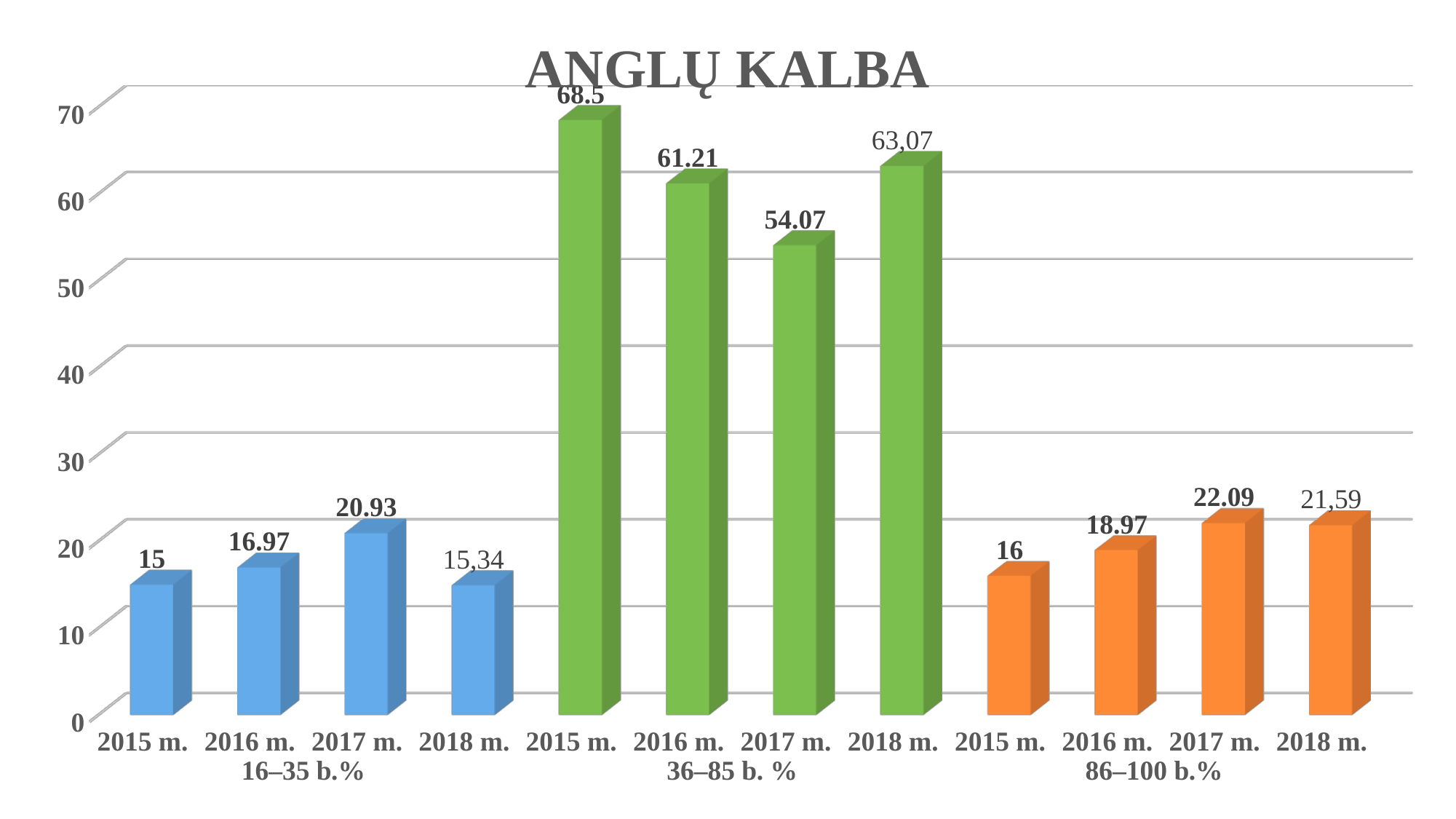
How many bars are plotted on the chart? 12 Which bar has the lowest value on the chart? 2015 m. in the 16–35 b.% group What kind of chart is shown on the slide? bar chart What is the difference between the 2015 m. and 2017 m. values in the 36–85 b. % group? 14.43 Do the values in the 86–100 b.% group rise or fall from 2015 m. to 2017 m.? rise Is the value for 2016 m. in the 36–85 b. % group greater or less than 60? greater Which bar has the highest value on the chart? 2015 m. in the 36–85 b. % group What is the title of the chart? ANGLŲ KALBA What is the value for 2018 m. in the 86–100 b.% group? 21,59 Which is larger: the 2017 m. value in the 16–35 b.% group or the 2017 m. value in the 86–100 b.% group? 2017 m. in the 86–100 b.% group What is the value for 2015 m. in the 36–85 b. % group? 68.5 What is the value for 2017 m. in the 16–35 b.% group? 20.93